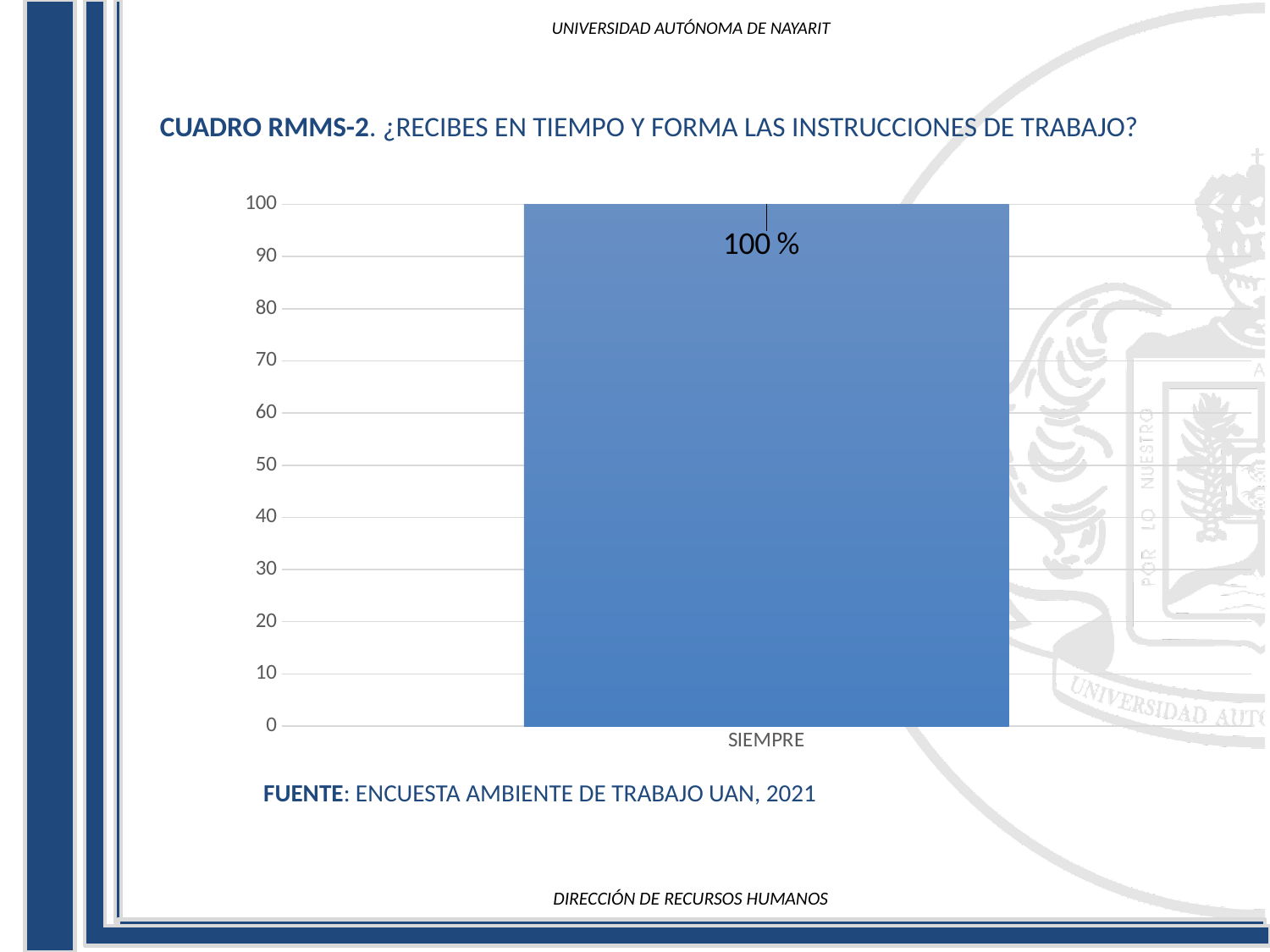
Which category has the highest value? SIEMPRE What is the value shown for SIEMPRE? 100 % What kind of chart is shown on the slide? bar chart What is the highest value shown on the vertical axis? 100 What is the label of the only category on the x axis? SIEMPRE How many categories are plotted on the x axis? 1 Is the value for SIEMPRE greater or less than 50? greater